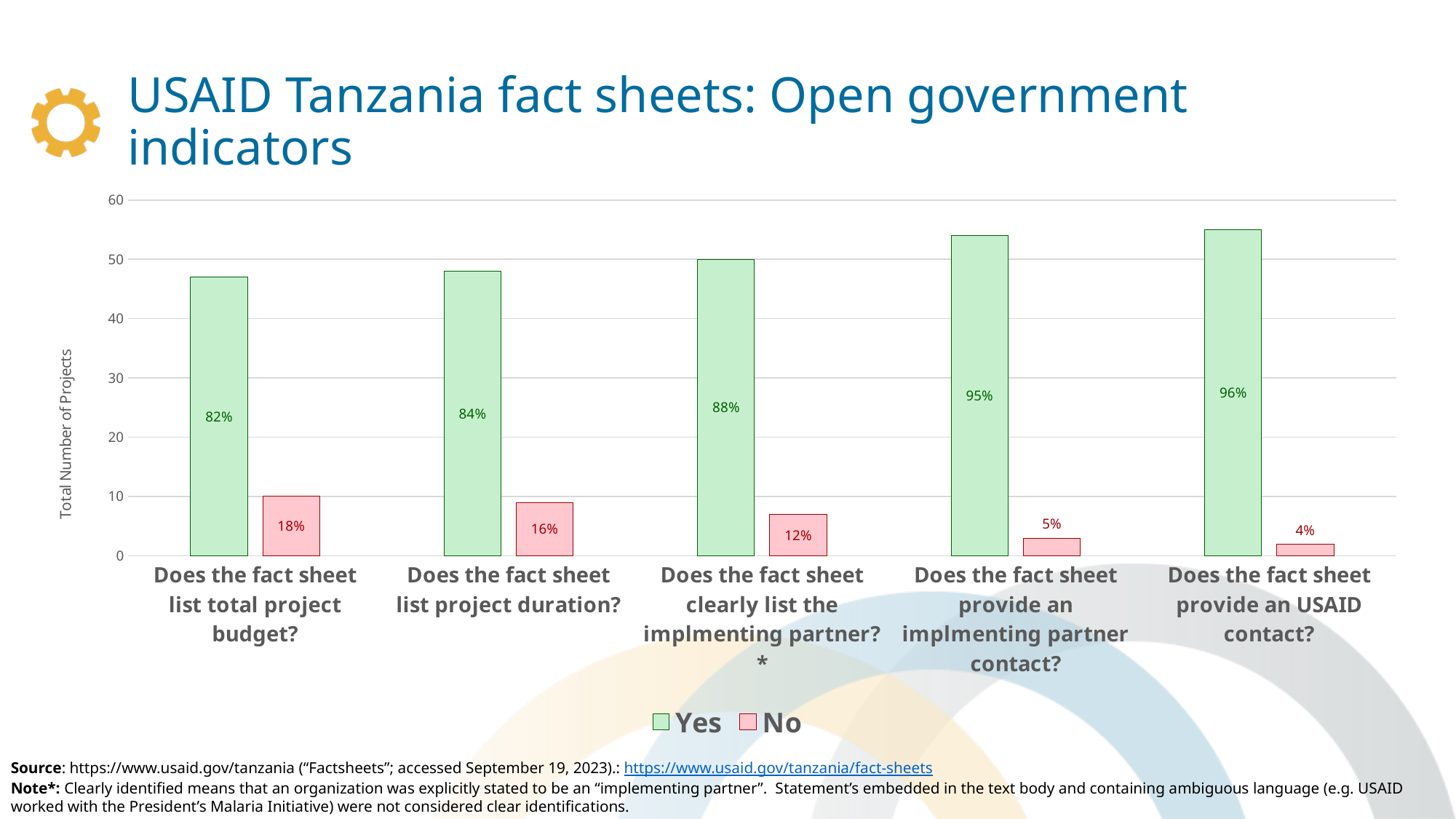
Which question has the highest Yes percentage? Does the fact sheet provide an USAID contact? What percentage label is shown on the No bar for "Does the fact sheet clearly list the implmenting partner?"? 12% How many questions (categories) are shown on the x axis? 5 What percentage label is shown on the Yes bar for "Does the fact sheet list total project budget?"? 82% How many series does the legend list? 2 Which question has the lowest Yes percentage? Does the fact sheet list total project budget? What percentage label is shown on the Yes bar for "Does the fact sheet provide an USAID contact?"? 96% What percentage label is shown on the No bar for "Does the fact sheet list project duration?"? 16% Is the Yes bar for "Does the fact sheet list total project budget?" greater or less than 50 on the Total Number of Projects axis? less Is the Yes bar for "Does the fact sheet provide an USAID contact?" greater or less than 50 on the Total Number of Projects axis? greater Which is larger: the No percentage for "list total project budget?" or the No percentage for "provide an USAID contact?"? list total project budget? What is the difference in percentage points between the Yes and No labels for "Does the fact sheet provide an implmenting partner contact?"? 90